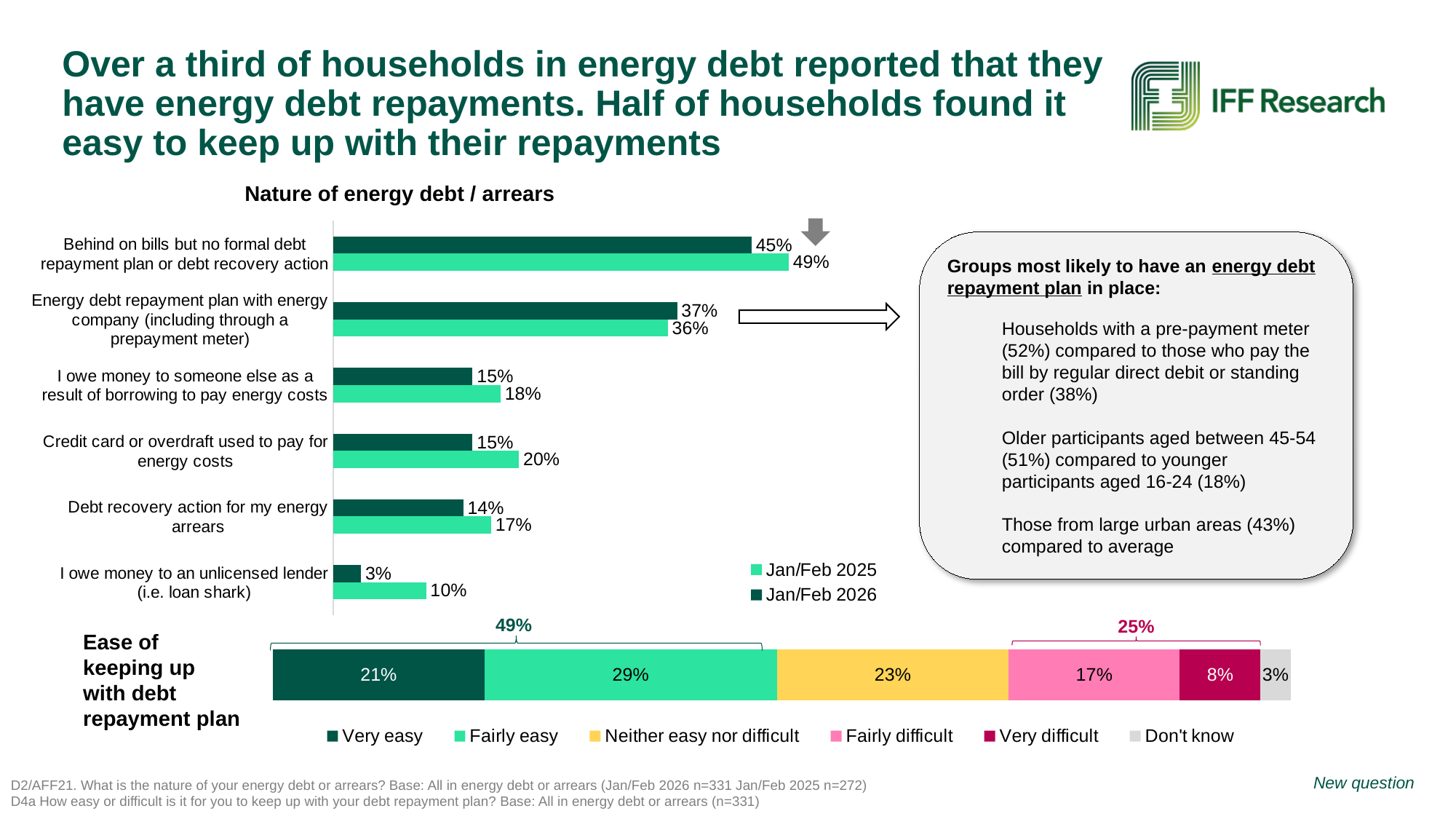
In the 'Nature of energy debt / arrears' chart, what is the difference between the Jan/Feb 2025 and Jan/Feb 2026 values for 'I owe money to an unlicensed lender (i.e. loan shark)'? 7 percentage points In the 'Nature of energy debt / arrears' chart, which category has the highest Jan/Feb 2025 value? Behind on bills but no formal debt repayment plan or debt recovery action In the 'Nature of energy debt / arrears' chart, is the Jan/Feb 2026 value for 'Energy debt repayment plan with energy company' larger or smaller than the Jan/Feb 2025 value? larger In the 'Ease of keeping up with debt repayment plan' chart, what is the value for 'Neither easy nor difficult'? 23% In the 'Ease of keeping up with debt repayment plan' chart, what is the combined total of 'Fairly difficult' and 'Very difficult'? 25% In the 'Nature of energy debt / arrears' chart, what is the Jan/Feb 2026 value for 'Behind on bills but no formal debt repayment plan or debt recovery action'? 45% In the 'Nature of energy debt / arrears' chart, which category has the lowest Jan/Feb 2026 value? I owe money to an unlicensed lender (i.e. loan shark) How many series does the legend of the 'Nature of energy debt / arrears' chart list? 2 What kind of chart is the 'Ease of keeping up with debt repayment plan' chart? Stacked bar chart How many segments does the legend of the 'Ease of keeping up with debt repayment plan' chart list? 6 How many categories are shown in the 'Nature of energy debt / arrears' chart? 6 In the 'Nature of energy debt / arrears' chart, what is the Jan/Feb 2025 value for 'Credit card or overdraft used to pay for energy costs'? 20%